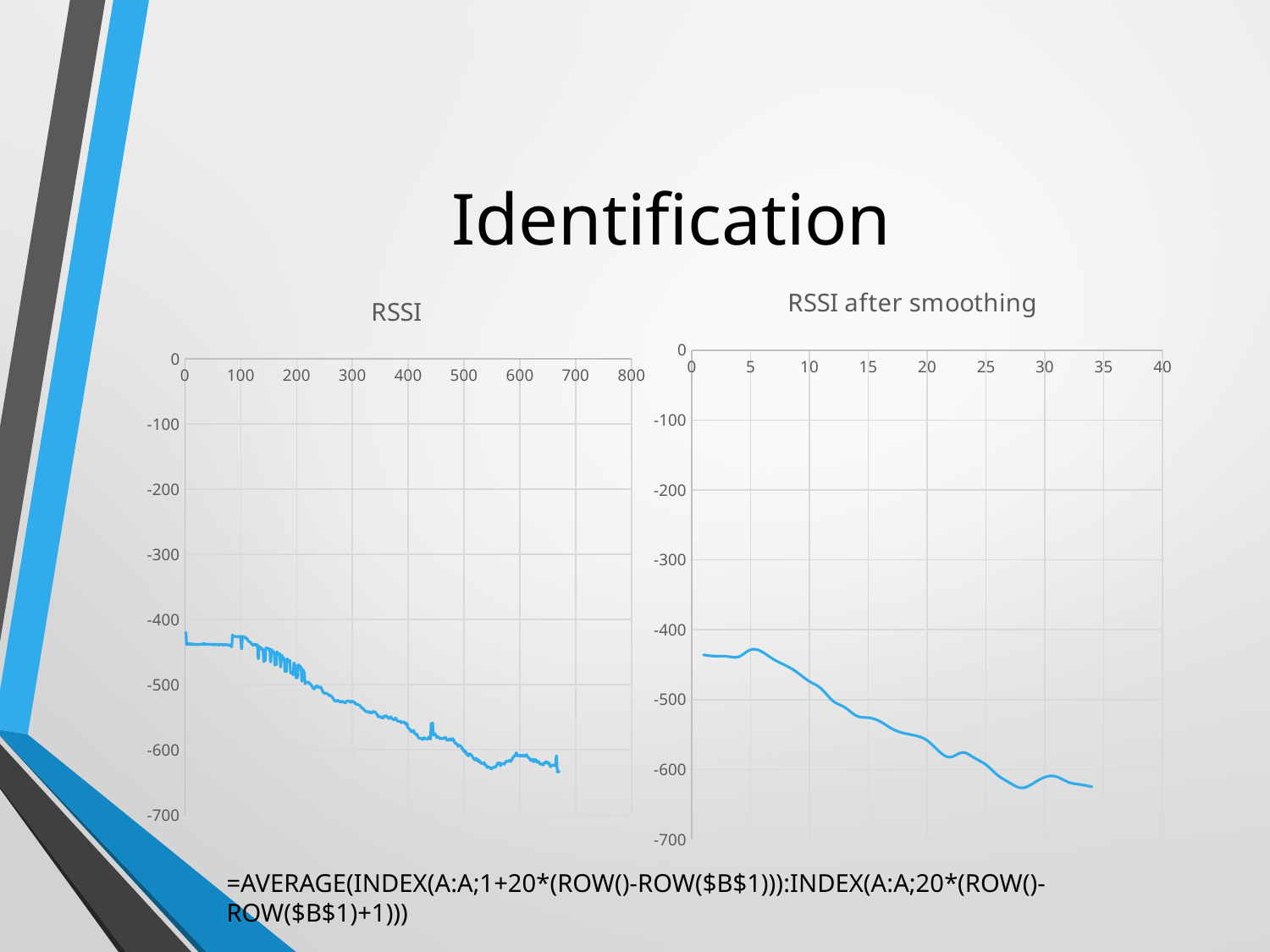
In the chart titled "RSSI after smoothing", is the value at x = 20 greater or less than -500? less What kind of chart is the chart titled "RSSI"? line chart What kind of chart is the chart titled "RSSI after smoothing"? line chart What is the highest x-axis tick label shown on the chart titled "RSSI after smoothing"? 40 In the chart titled "RSSI after smoothing", is the value at x = 5 greater or less than -500? greater In the chart titled "RSSI after smoothing", is the value at x = 15 greater or less than -600? greater In the chart titled "RSSI after smoothing", do the values rise or fall as the x axis increases? fall What is the title of the chart on the right side of the slide? RSSI after smoothing In the chart titled "RSSI", do the values rise or fall as the x axis increases? fall